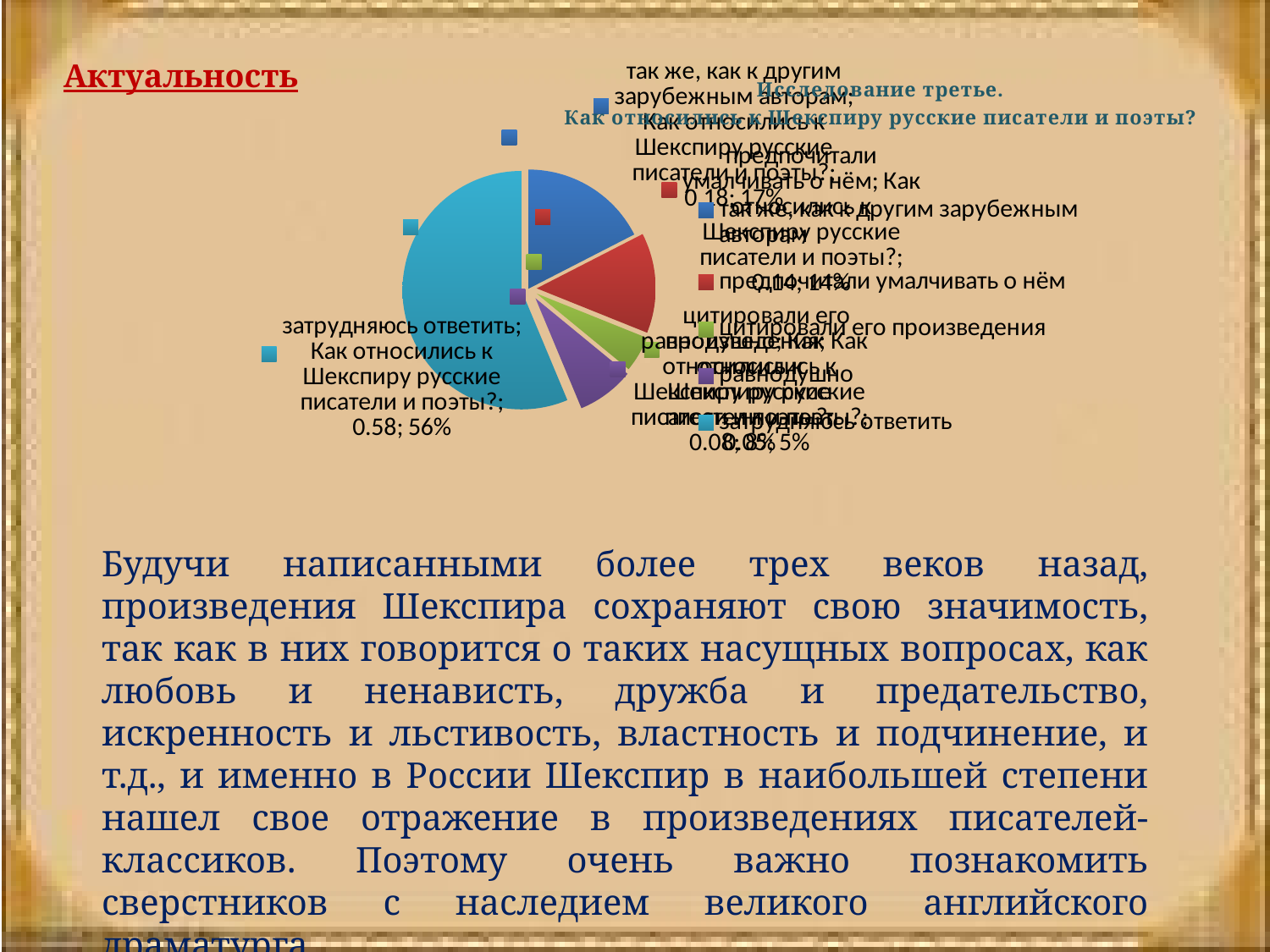
Which answer option has the largest share of the pie? затрудняюсь ответить What colour is the largest slice of the pie? light blue What share of the pie does "затрудняюсь ответить" have? 56% What is the difference in percentage points between "затрудняюсь ответить" and "так же, как к другим зарубежным авторам"? 39 Which is larger: the share for "так же, как к другим зарубежным авторам" or for "предпочитали умалчивать о нём"? так же, как к другим зарубежным авторам How many slices does the pie chart have? 5 How many answer options does the legend list? 5 What percentage is shown for "предпочитали умалчивать о нём"? 14% Which answer option has the smallest slice of the pie? цитировали его произведения What percentage is shown for "так же, как к другим зарубежным авторам"? 17% What kind of chart is shown on the slide? pie chart What question does the chart title say was asked? Как относились к Шекспиру русские писатели и поэты?